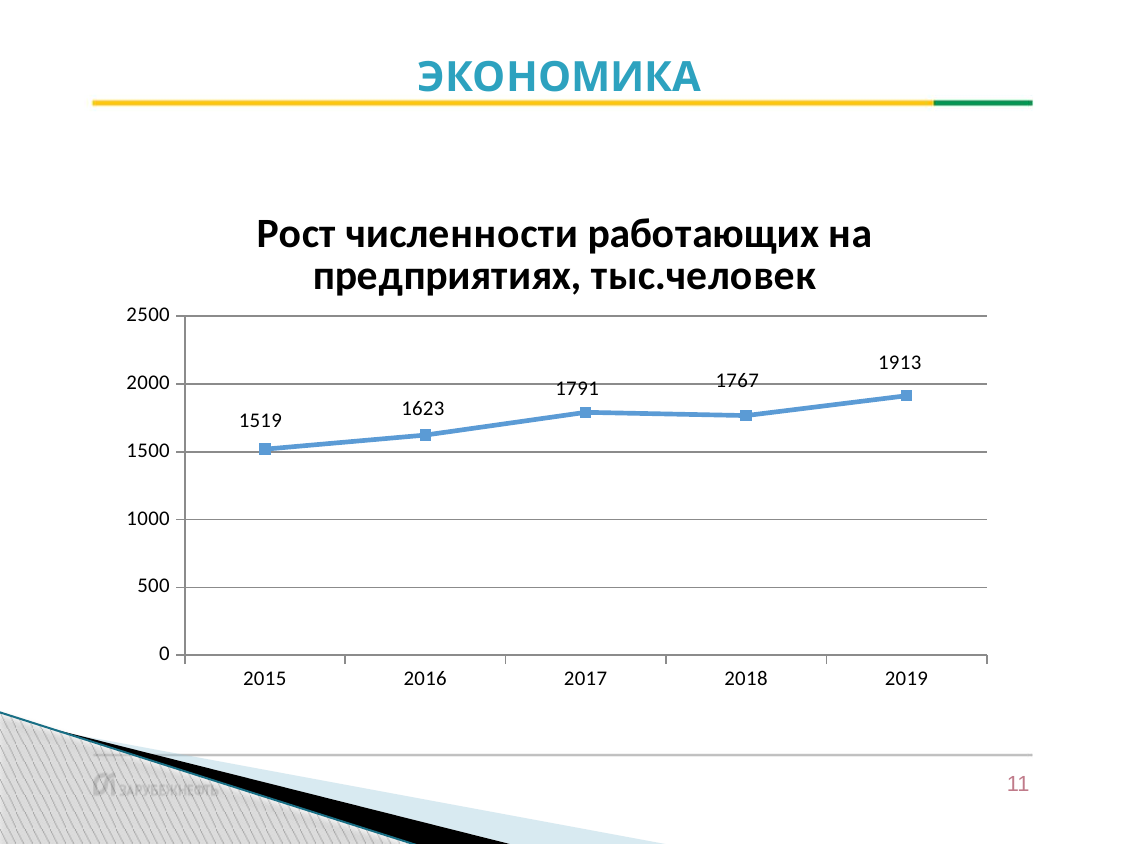
What kind of chart is shown on the slide? line chart What is the value for 2019? 1913 Which year has the lowest value? 2015 Which year has the highest value? 2019 What is the title of the chart? Рост численности работающих на предприятиях, тыс.человек What is the difference between the values for 2017 and 2018? 24 What is the value for 2015? 1519 Is the value for 2016 greater or less than 2000? less What is the difference between the values for 2019 and 2015? 394 What is the value for 2017? 1791 How many years are plotted on the chart? 5 Which is larger, the value for 2016 or the value for 2018? 2018